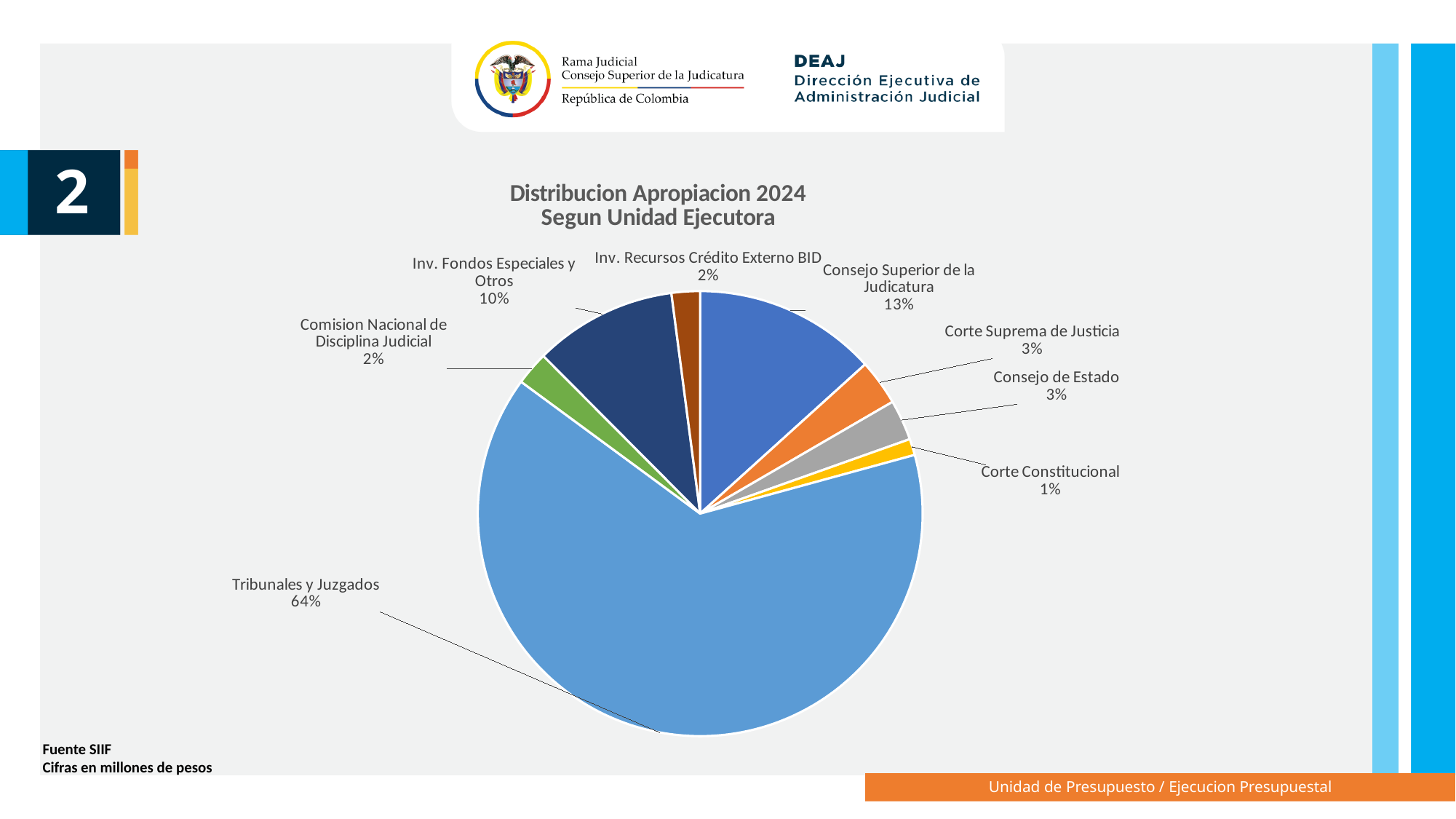
What kind of chart is shown on the slide? Pie chart Which is larger, the share for Consejo Superior de la Judicatura or the share for Corte Suprema de Justicia? Consejo Superior de la Judicatura What percentage is shown for Corte Constitucional? 1% What is the title of the chart? Distribucion Apropiacion 2024 Segun Unidad Ejecutora What percentage is shown for Comision Nacional de Disciplina Judicial? 2% What percentage is shown for Consejo Superior de la Judicatura? 13% Which category has the smallest slice of the pie? Corte Constitucional What is the difference in percentage points between Consejo Superior de la Judicatura and Inv. Fondos Especiales y Otros? 3 percentage points What share of the pie does Tribunales y Juzgados represent? 64% Which category has the largest slice of the pie? Tribunales y Juzgados What percentage is shown for Inv. Fondos Especiales y Otros? 10% How many categories (slices) does the pie chart have? 8